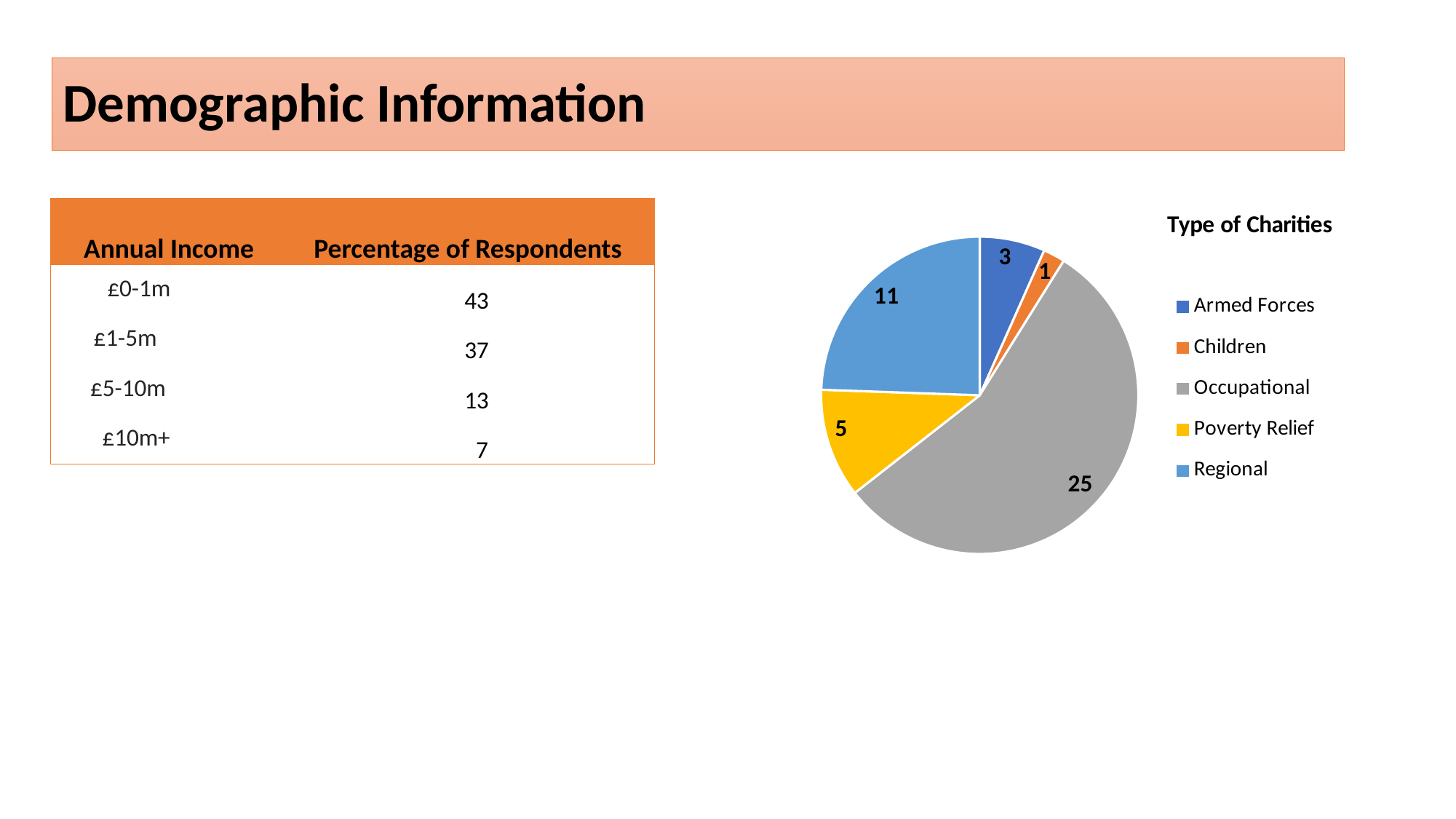
What is the value for Poverty Relief in the Type of Charities pie chart? 5 What type of chart is shown on the slide? pie chart Which category has the smallest slice in the Type of Charities pie chart? Children What is the total of all the slice values in the Type of Charities pie chart? 45 What is the value for Armed Forces in the Type of Charities pie chart? 3 Which category has the largest slice in the Type of Charities pie chart? Occupational Which is larger in the Type of Charities pie chart, Poverty Relief or Armed Forces? Poverty Relief What is the value for Regional in the Type of Charities pie chart? 11 What is the title of the pie chart? Type of Charities What is the difference between the Occupational and Regional values in the Type of Charities pie chart? 14 What is the value for Occupational in the Type of Charities pie chart? 25 How many categories does the Type of Charities pie chart show? 5